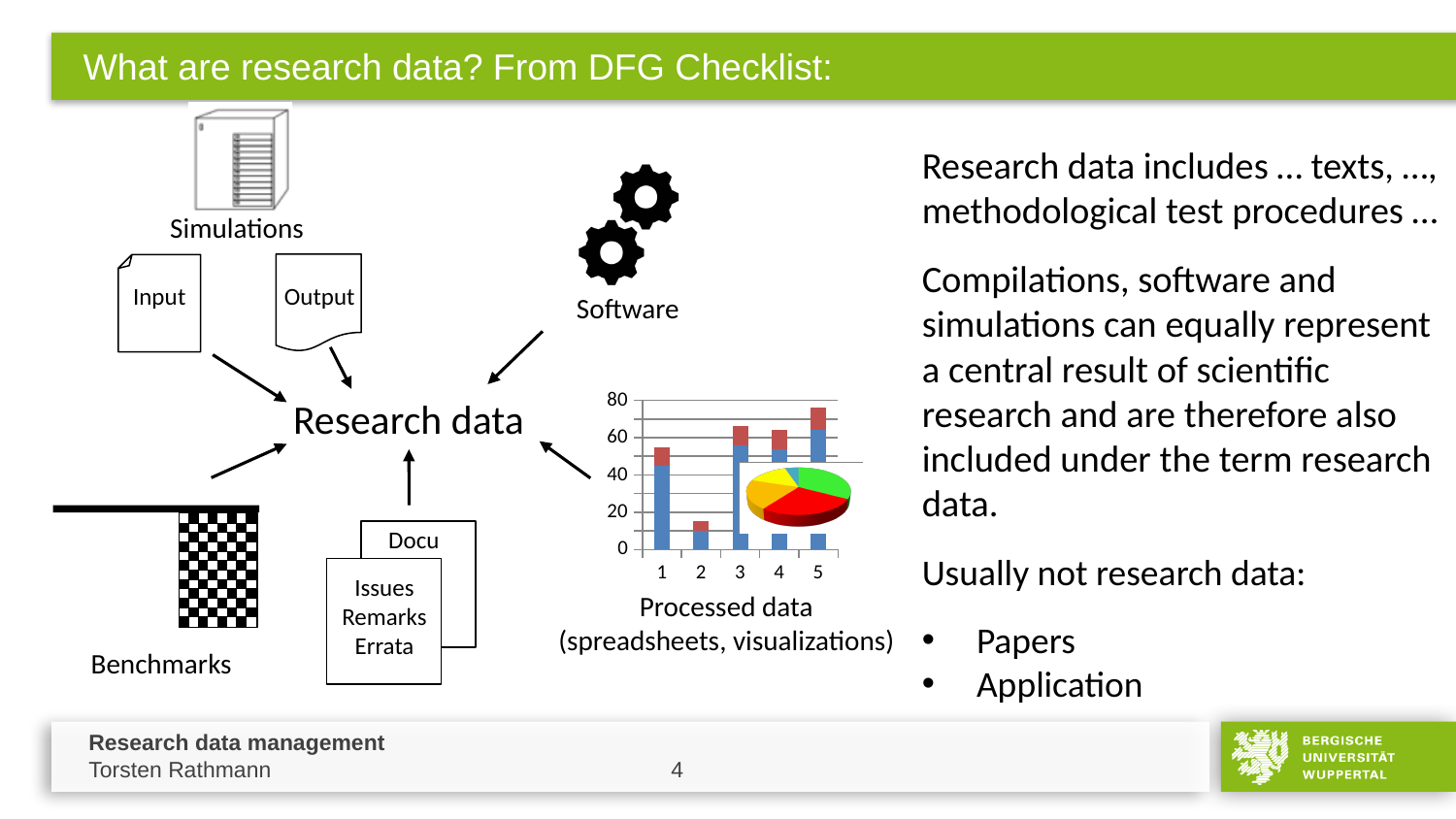
In the bar chart under "Processed data", which bar is taller, category 2 or category 5? category 5 In the bar chart under "Processed data", which category has the highest bar? 5 In the bar chart under "Processed data", is the total value for category 1 greater or less than 40? greater What kind of chart is the chart labelled "Processed data" on the slide? bar chart In the bar chart under "Processed data", is the total value for category 1 greater or less than 60? less What is the highest tick value shown on the y axis of the bar chart under "Processed data"? 80 In the bar chart under "Processed data", is the total value for category 5 greater or less than 60? greater What type of chart is overlaid on top of the bar chart under "Processed data"? pie chart In the bar chart under "Processed data", which bar is taller, category 1 or category 2? category 1 How many categories are shown on the x axis of the bar chart under "Processed data"? 5 In the bar chart under "Processed data", which category has the lowest bar? 2